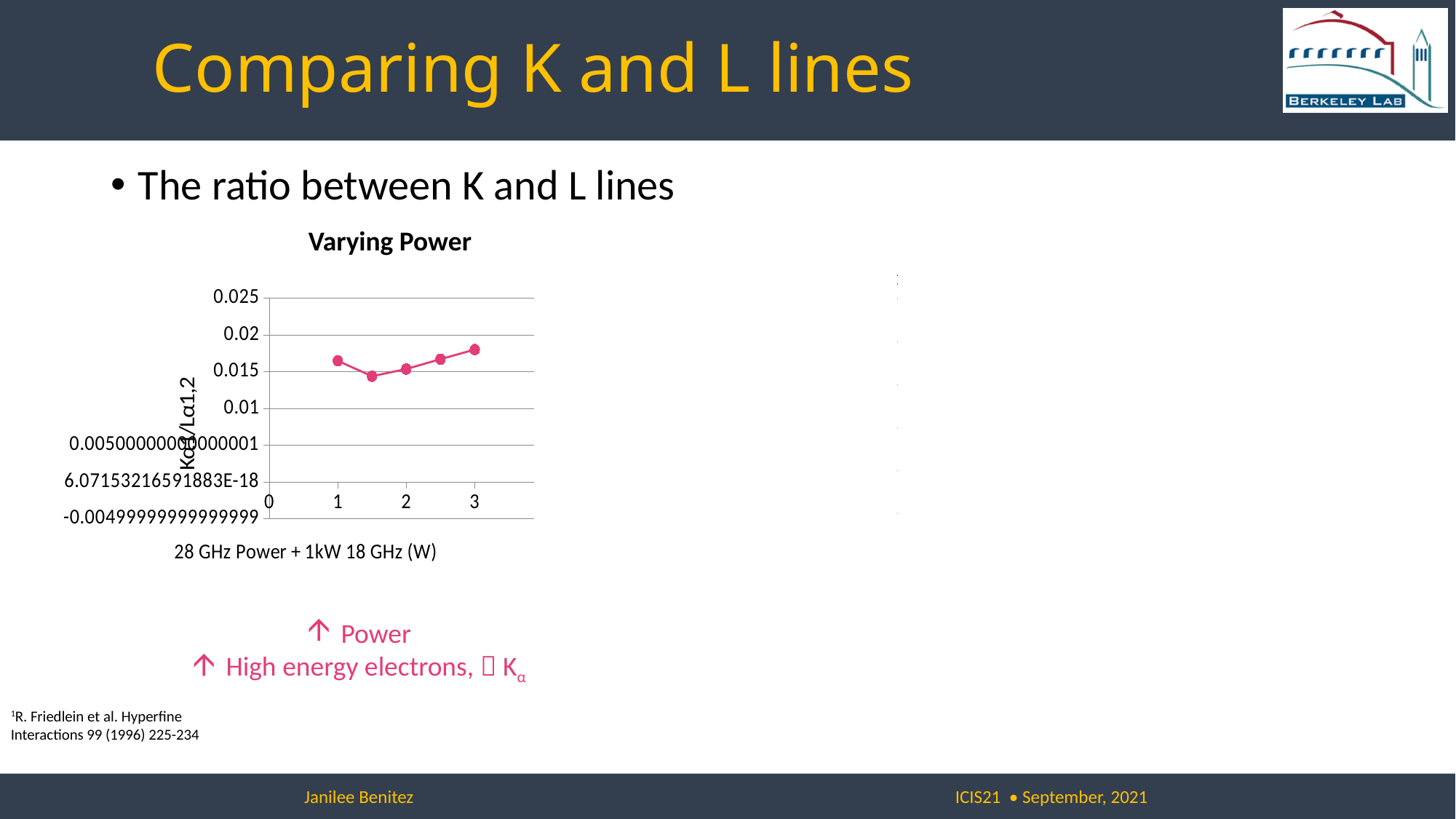
On the "Varying Power" chart, do the values rise or fall from x = 1 to x = 1.5? fall How many data points are plotted on the "Varying Power" chart? 5 What is the title of the chart on the slide? Varying Power What is the x-axis label of the "Varying Power" chart? 28 GHz Power + 1kW 18 GHz (W) On the "Varying Power" chart, is the value at x = 1.5 greater or less than 0.015? less What kind of chart is the "Varying Power" chart? line chart On the "Varying Power" chart, is the value at x = 3 greater or less than 0.02? less On the "Varying Power" chart, which is larger: the value at x = 3 or the value at x = 1.5? x = 3 On the "Varying Power" chart, do the values rise or fall from x = 1.5 to x = 3? rise On the "Varying Power" chart, at which x value is the plotted value lowest? 1.5 On the "Varying Power" chart, at which x value is the plotted value highest? 3 On the "Varying Power" chart, is the value at x = 3 greater or less than 0.015? greater